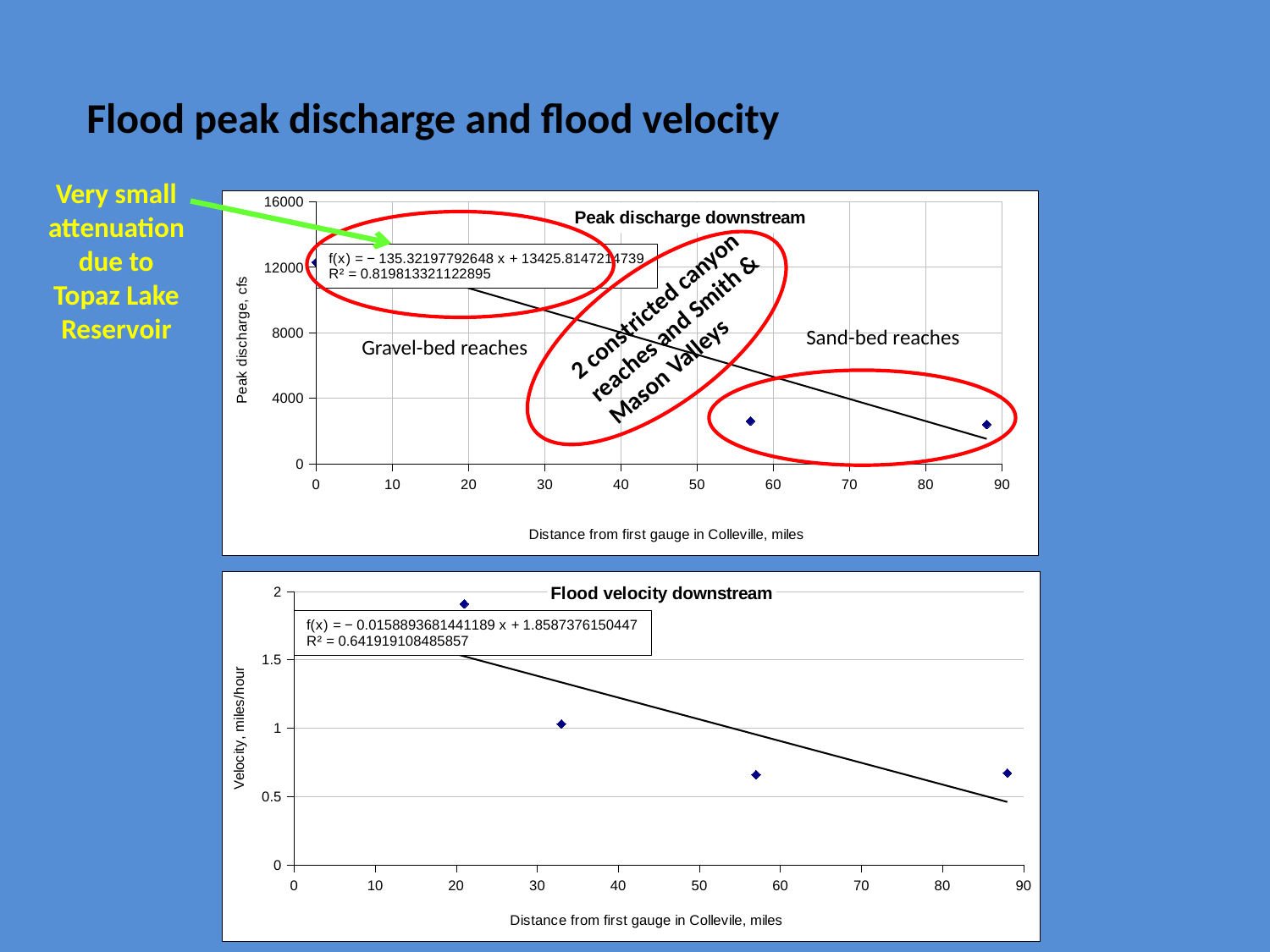
What kind of chart is the 'Peak discharge downstream' chart? scatter chart In the 'Flood velocity downstream' chart, does the trendline rise or fall as distance increases? fall In the 'Peak discharge downstream' chart, is the peak discharge at about 57 miles greater or less than 4000 cfs? less In the 'Flood velocity downstream' chart, what is the R² value shown for the trendline? 0.641919108485857 What is the y-axis label of the 'Peak discharge downstream' chart? Peak discharge, cfs In the 'Flood velocity downstream' chart, is the velocity at about 57 miles greater or less than 1 mile/hour? less In the 'Flood velocity downstream' chart, is the velocity at about 21 miles greater or less than 1.5 miles/hour? greater In the 'Peak discharge downstream' chart, what is the R² value shown for the trendline? 0.819813321122895 In the 'Flood velocity downstream' chart, which point has the higher velocity: the one at about 21 miles or the one at about 33 miles? the one at about 21 miles In the 'Flood velocity downstream' chart, how many data points are plotted? 4 What kind of chart is the 'Flood velocity downstream' chart? scatter chart